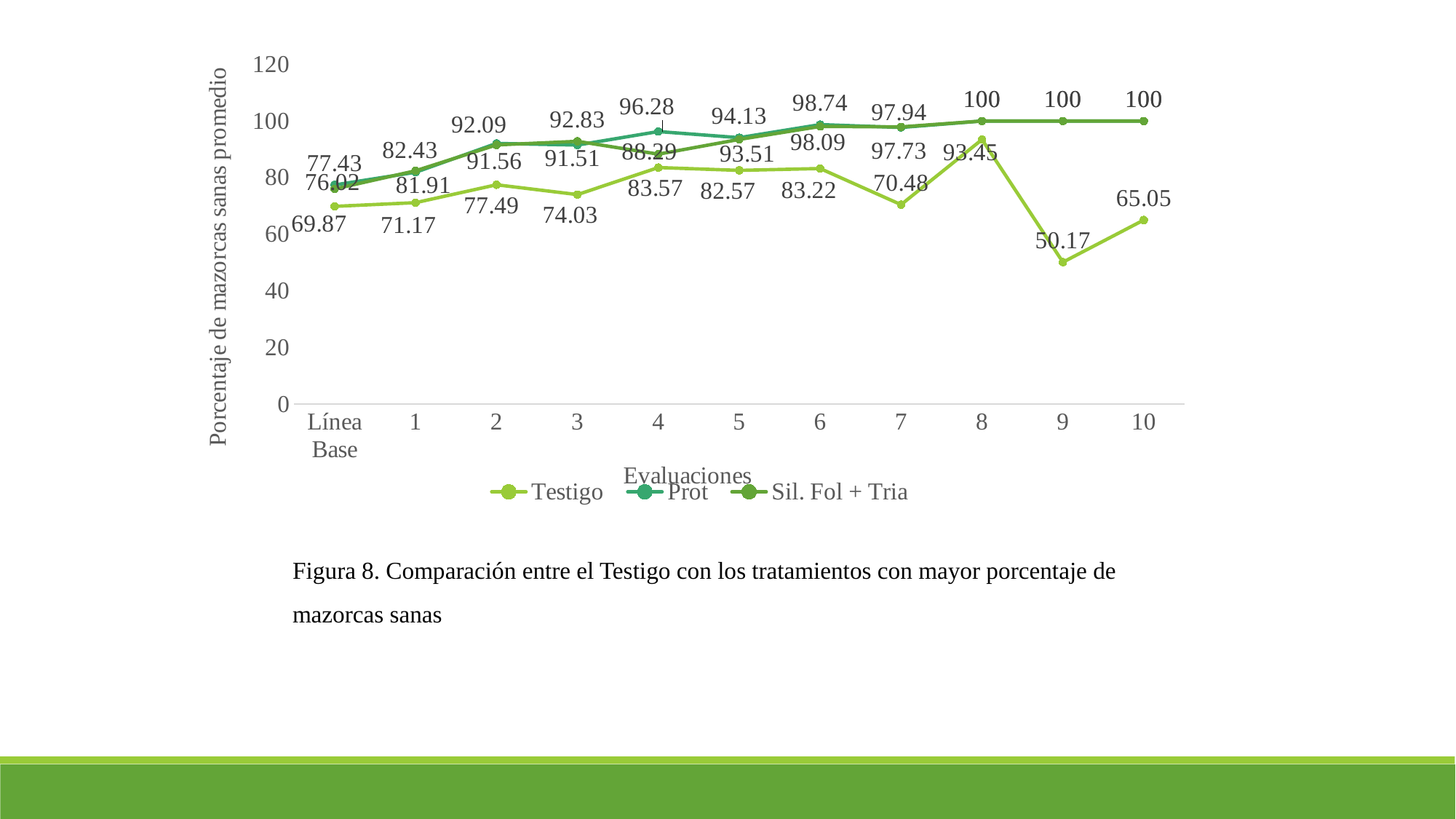
What is the value of the Sil. Fol + Tria series at evaluation 4? 88.29 Is the Testigo value at evaluation 9 greater or less than 60? less What kind of chart is shown on the slide? line chart What is the difference between the Testigo values at evaluation 8 and evaluation 9? 43.28 At which evaluation does the Testigo series reach its lowest value? 9 What is the value of the Testigo series at Línea Base? 69.87 How many series does the legend list? 3 At which evaluation does the Testigo series reach its highest value? 8 How many evaluation points are shown on the x axis? 11 What is the value of the Testigo series at evaluation 9? 50.17 What is the value of the Prot series at evaluation 4? 96.28 At evaluation 4, which series has the higher value, Prot or Sil. Fol + Tria? Prot